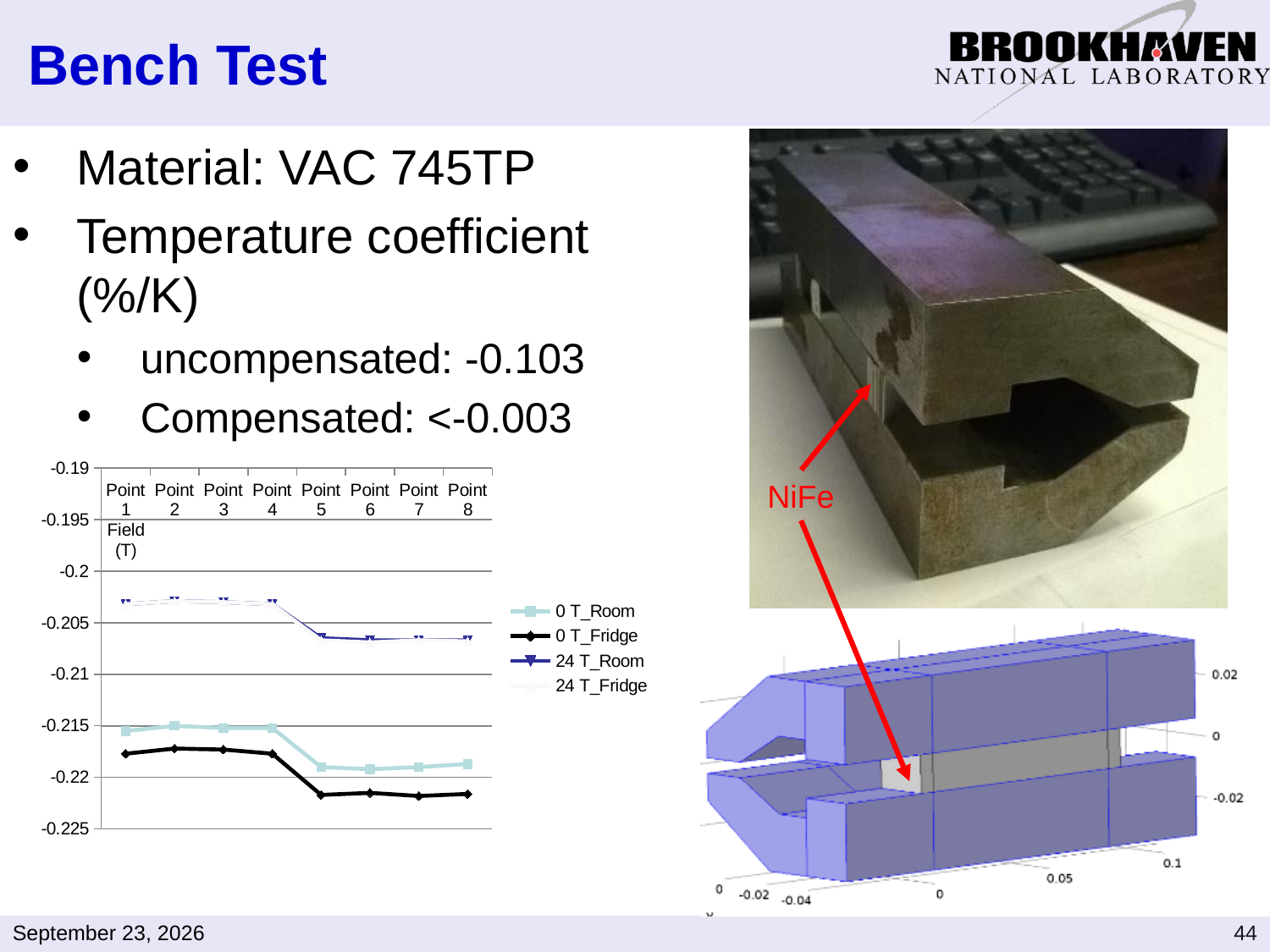
At Point 1, which series has the higher value: 24 T_Room or 0 T_Room? 24 T_Room Is the value of 0 T_Room at Point 5 greater or less than -0.215? less Is the value of 0 T_Fridge at Point 1 greater or less than -0.215? less Does the 0 T_Fridge series rise or fall between Point 4 and Point 5? fall What kind of chart is shown on the slide? line chart Is the value of 0 T_Fridge at Point 6 greater or less than -0.22? less What are the four series named in the chart's legend? 0 T_Room, 0 T_Fridge, 24 T_Room, 24 T_Fridge Which series has the lowest values across the chart? 0 T_Fridge How many points are plotted along the x axis of the chart? 8 How many series does the chart's legend list? 4